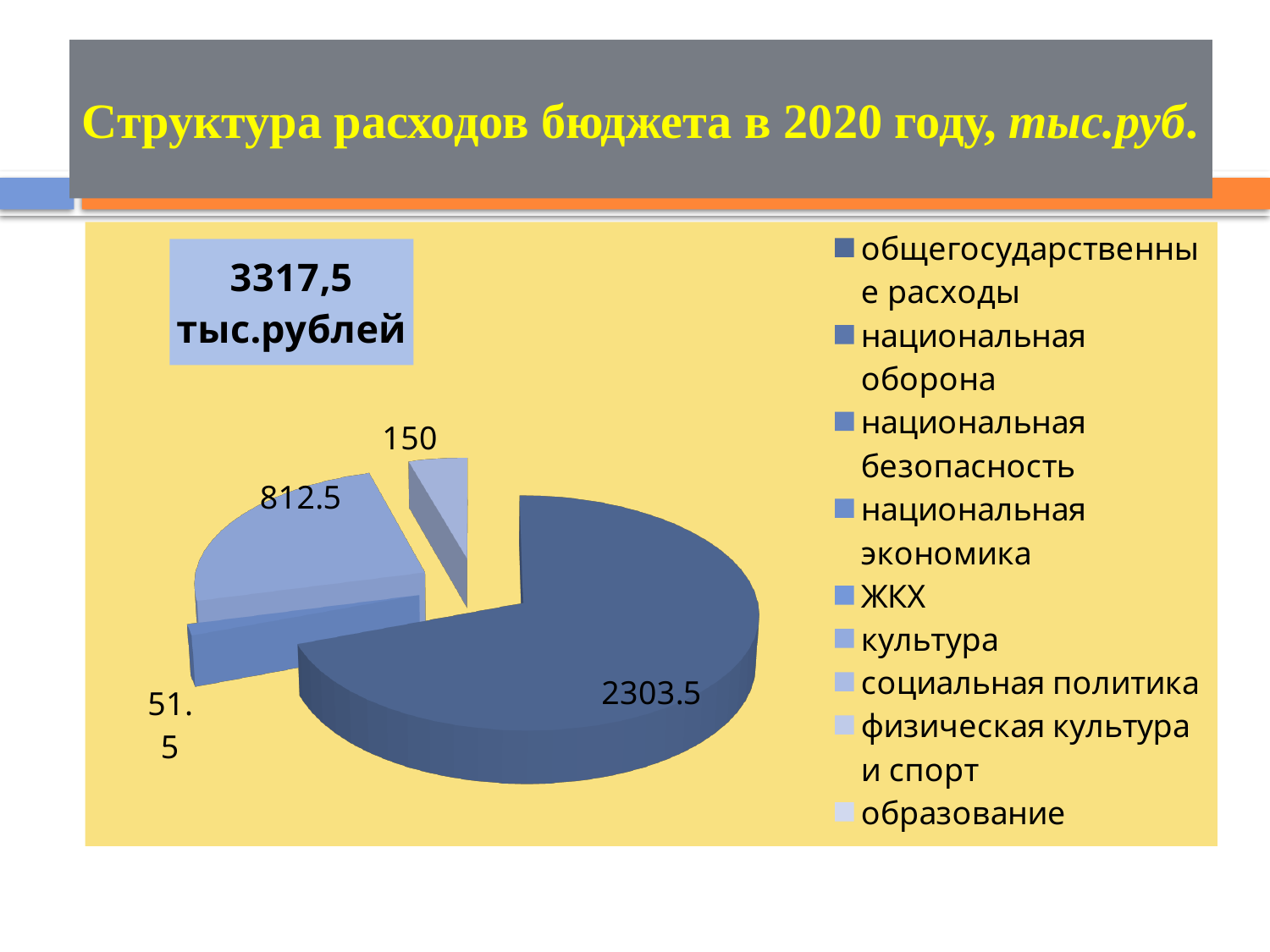
What is the title of the slide containing the pie chart? Структура расходов бюджета в 2020 году, тыс.руб. What kind of chart is shown on the slide? pie chart What is the difference between the slice labelled 812.5 and the slice labelled 150? 662.5 Which is larger: the slice labelled 812.5 or the slice labelled 150? 812.5 What is the value of the largest slice of the pie chart? 2303.5 What total amount is shown in the box on the chart? 3317,5 тыс.рублей Which legend entry corresponds to the largest (darkest) slice of the pie chart? общегосударственные расходы What is the difference between the slice labelled 2303.5 and the slice labelled 812.5? 1491 What is the difference between the slice labelled 150 and the slice labelled 51.5? 98.5 What is the value of the smallest labelled slice of the pie chart? 51.5 How many slices of the pie chart have a printed data label? 4 How many entries does the legend of the pie chart list? 9